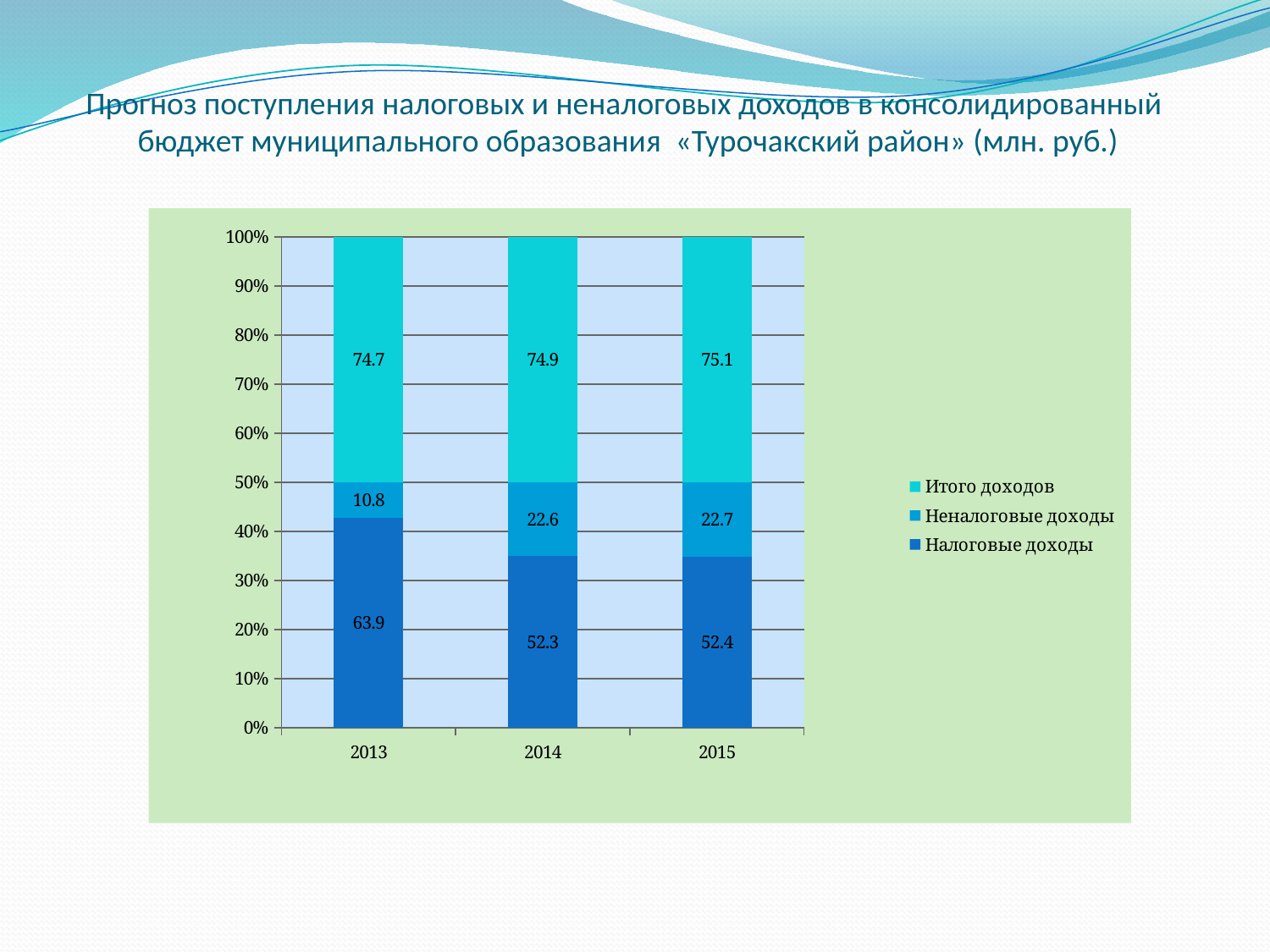
In which year is Налоговые доходы highest? 2013 What is the value of Неналоговые доходы for 2014? 22.6 Which is larger: Неналоговые доходы in 2013 or in 2015? 2015 How many series does the legend list? 3 What is the value of Итого доходов for 2015? 75.1 What kind of chart is shown on the slide? Stacked bar chart What is the difference between Налоговые доходы in 2013 and 2014? 11.6 Does Неналоговые доходы rise or fall from 2013 to 2015? Rise Which legend entry is shown in the darkest blue colour? Налоговые доходы In which year is Неналоговые доходы lowest? 2013 How many years are shown on the x axis? 3 What is the value of Налоговые доходы for 2013? 63.9